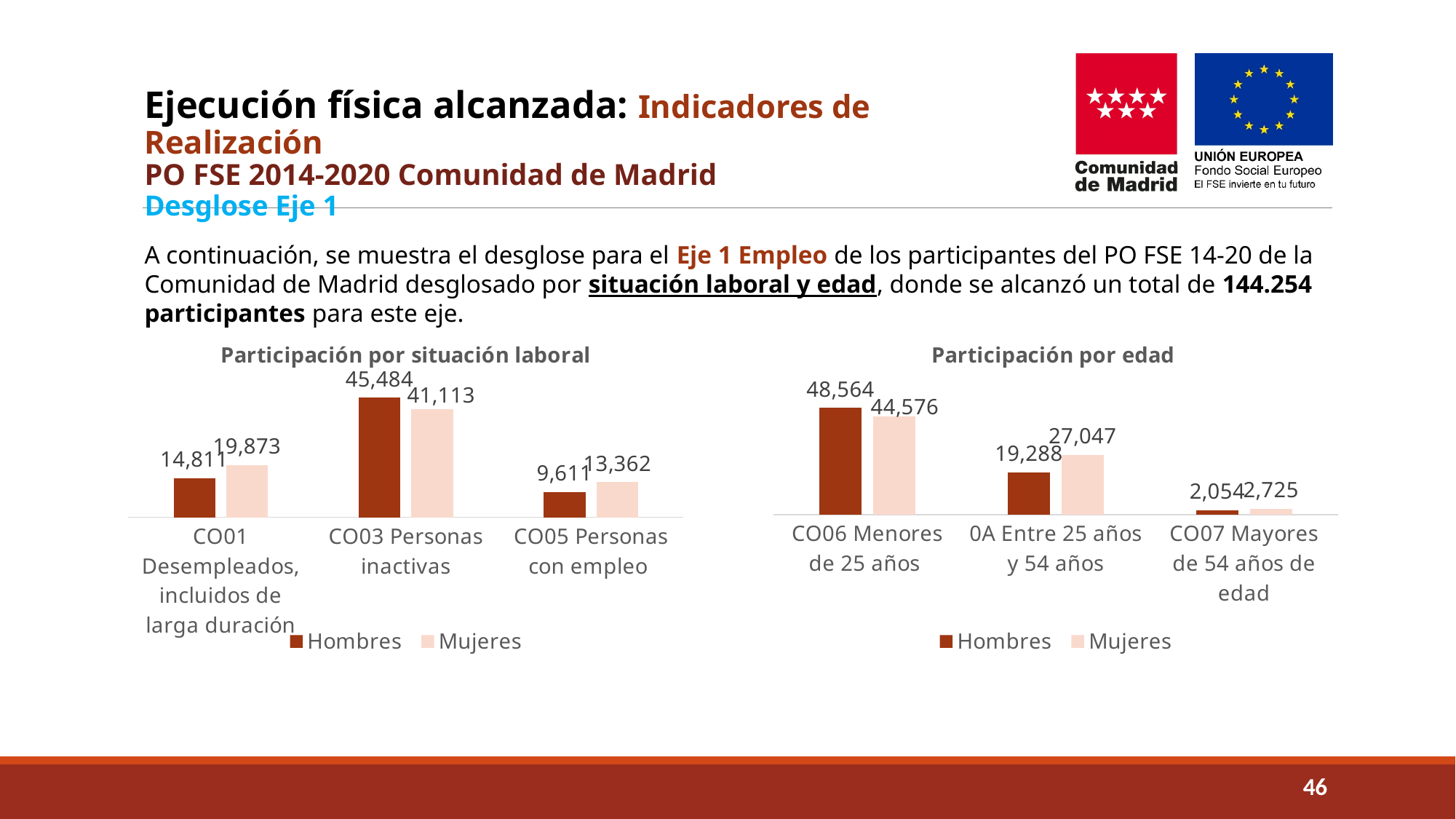
In the 'Participación por edad' chart, what is the Mujeres value for 0A Entre 25 años y 54 años? 27,047 How many categories are shown in the 'Participación por situación laboral' chart? 3 What type of chart is the 'Participación por edad' chart? Bar chart How many series does the legend of the 'Participación por edad' chart list? 2 In the 'Participación por edad' chart, which category has the lowest Mujeres value? CO07 Mayores de 54 años de edad In the 'Participación por situación laboral' chart, what is the difference between the Mujeres and Hombres values for CO01 Desempleados, incluidos de larga duración? 5,062 In the 'Participación por edad' chart, what is the difference between the Hombres and Mujeres values for CO06 Menores de 25 años? 3,988 In the 'Participación por situación laboral' chart, what is the Mujeres value for CO05 Personas con empleo? 13,362 In the 'Participación por edad' chart, what is the Hombres value for CO07 Mayores de 54 años de edad? 2,054 In the 'Participación por edad' chart, which is larger for 0A Entre 25 años y 54 años: Hombres or Mujeres? Mujeres In the 'Participación por situación laboral' chart, what is the Hombres value for CO03 Personas inactivas? 45,484 In the 'Participación por situación laboral' chart, which category has the highest Hombres value? CO03 Personas inactivas